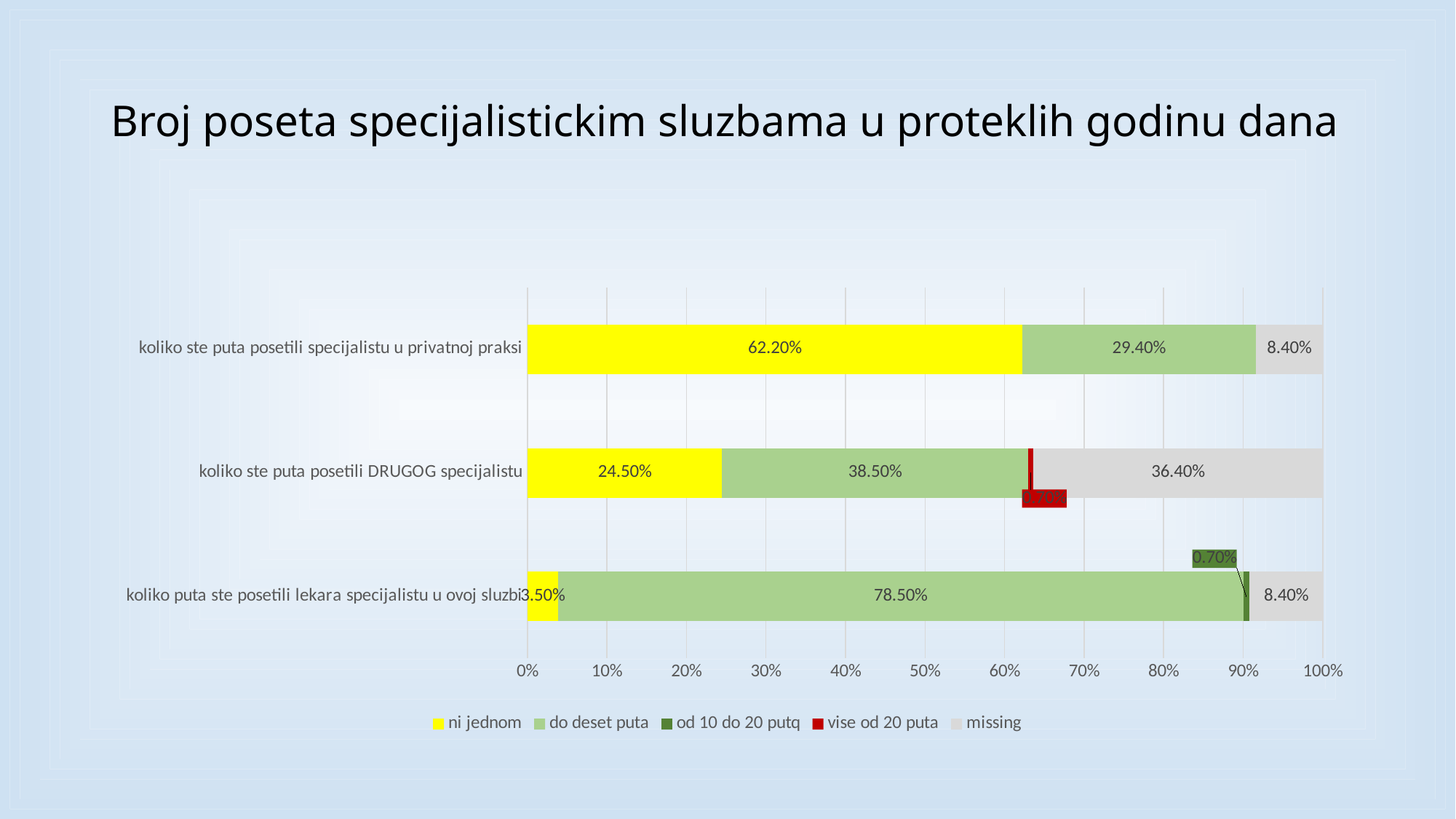
What is the value of "od 10 do 20 putq" for "koliko puta ste posetili lekara specijalistu u ovoj sluzbi"? 0.70% Which category has the lowest "ni jednom" value? koliko puta ste posetili lekara specijalistu u ovoj sluzbi How many categories are shown on the chart? 3 What is the total of the stacked bar for "koliko ste puta posetili specijalistu u privatnoj praksi"? 100.00% What kind of chart is shown on the slide? Stacked bar chart What is the "missing" value for "koliko ste puta posetili DRUGOG specijalistu"? 36.40% What is the value of "do deset puta" for "koliko puta ste posetili lekara specijalistu u ovoj sluzbi"? 78.50% What is the difference in "do deset puta" between "koliko puta ste posetili lekara specijalistu u ovoj sluzbi" and "koliko ste puta posetili DRUGOG specijalistu"? 40.00% Which category has the highest "ni jednom" value? koliko ste puta posetili specijalistu u privatnoj praksi Which has a larger "missing" value: "koliko ste puta posetili DRUGOG specijalistu" or "koliko ste puta posetili specijalistu u privatnoj praksi"? koliko ste puta posetili DRUGOG specijalistu What is the value of "ni jednom" for "koliko ste puta posetili specijalistu u privatnoj praksi"? 62.20% How many series does the legend list? 5